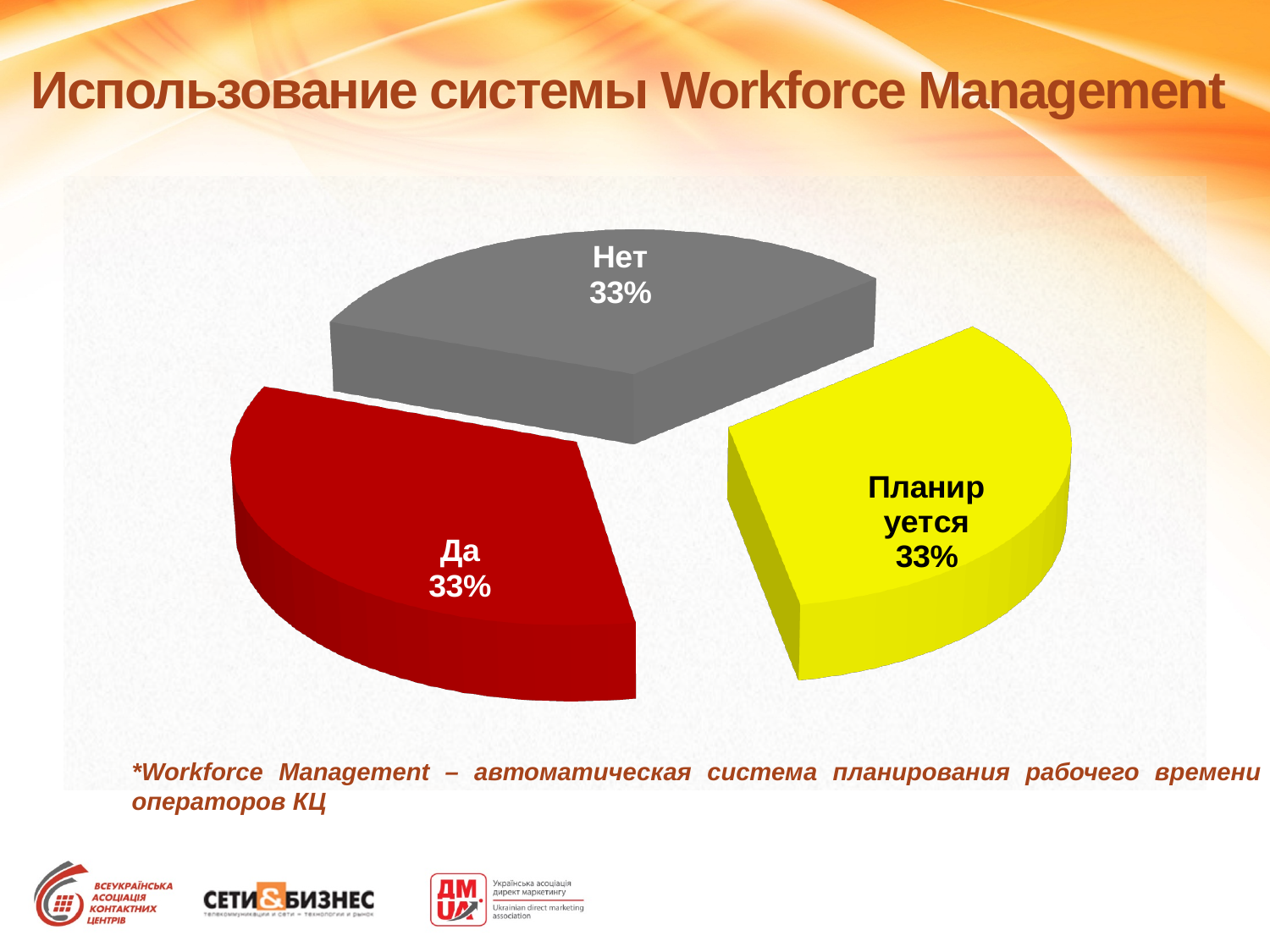
What colour is the "Да" slice of the pie chart? Red What share of the pie does the "Планируется" slice represent? 33% What kind of chart is shown on the slide? Pie chart What is the title of the slide containing the chart? Использование системы Workforce Management What is the value shown for the "Планируется" category? 33% What share of the pie does the "Нет" slice represent? 33% What share of the pie does the "Да" slice represent? 33% What is the difference between the values for "Да" and "Нет"? 0% How many slices does the pie chart have? 3 What is the value shown for the "Нет" category? 33%